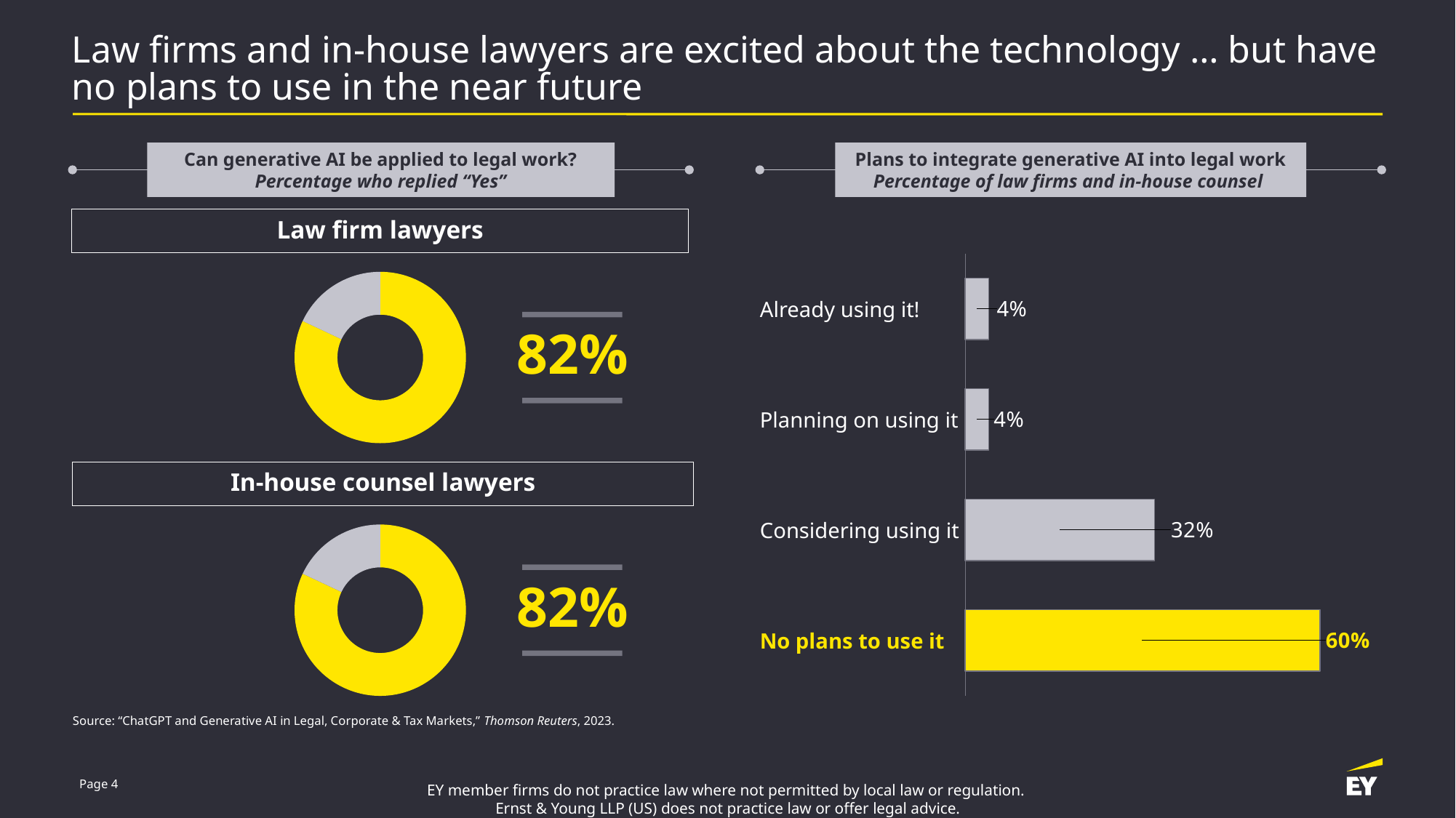
In the 'Plans to integrate generative AI into legal work' bar chart, what percentage are considering using it? 32% What type of chart is used for 'Plans to integrate generative AI into legal work'? Bar chart What type of chart is used to show the percentage of law firm lawyers who replied 'Yes'? Donut chart In the 'Plans to integrate generative AI into legal work' bar chart, which bar is highlighted in yellow? No plans to use it How many categories are shown in the 'Plans to integrate generative AI into legal work' bar chart? 4 In the 'Plans to integrate generative AI into legal work' bar chart, which is larger: 'Considering using it' or 'Planning on using it'? Considering using it In the 'Law firm lawyers' donut chart, what percentage replied 'Yes' that generative AI can be applied to legal work? 82% In the 'Plans to integrate generative AI into legal work' bar chart, what percentage have no plans to use it? 60% In the 'Plans to integrate generative AI into legal work' bar chart, what is the difference between 'No plans to use it' and 'Considering using it'? 28% In the 'Plans to integrate generative AI into legal work' bar chart, which category has the highest value? No plans to use it In the 'Plans to integrate generative AI into legal work' bar chart, what percentage are already using it? 4% In the 'In-house counsel lawyers' donut chart, what percentage replied 'Yes' that generative AI can be applied to legal work? 82%